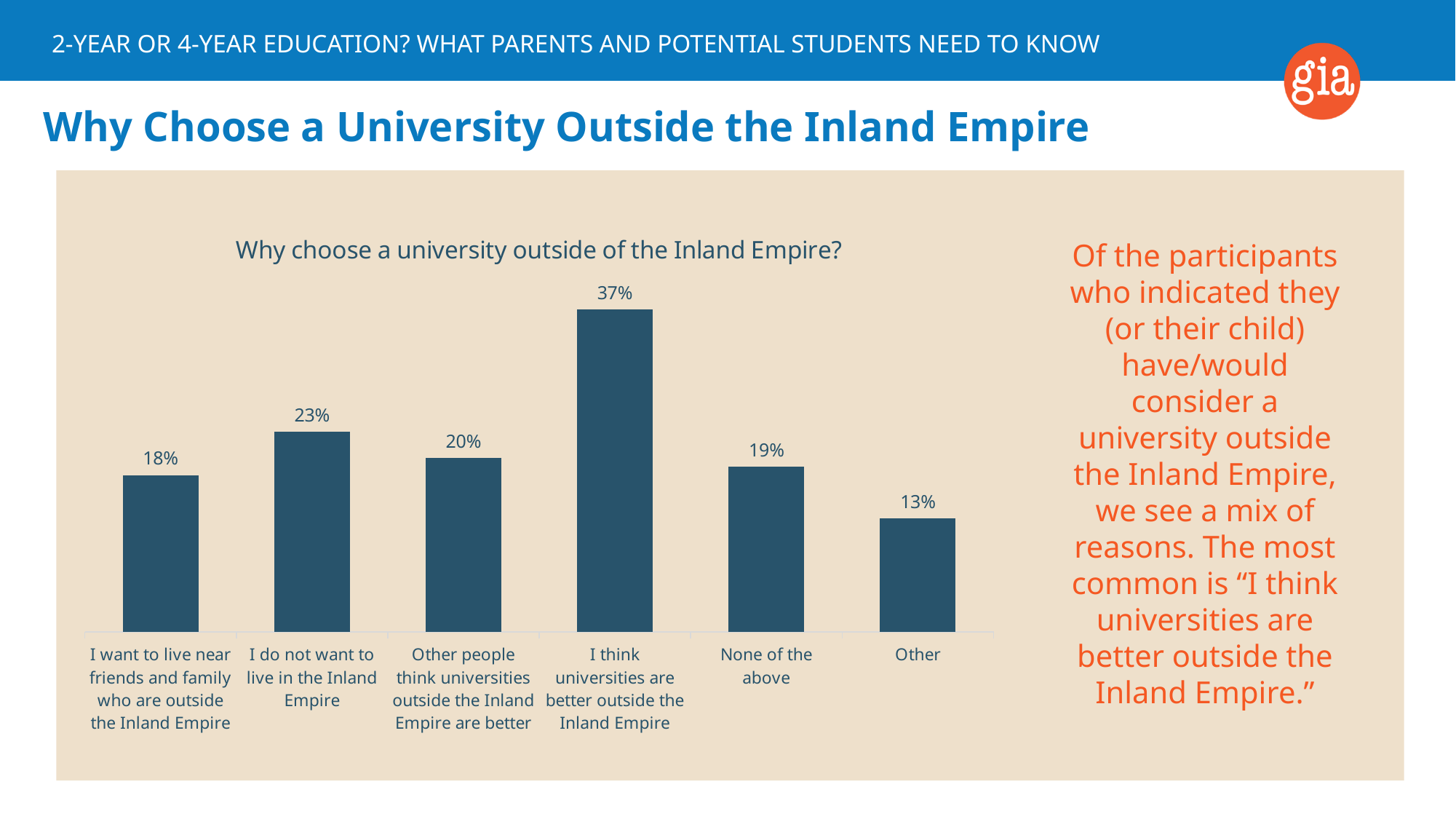
What is the difference between "I think universities are better outside the Inland Empire" and "I do not want to live in the Inland Empire"? 14% What is the difference between "Other people think universities outside the Inland Empire are better" and "Other"? 7% What type of chart is shown on the slide? Bar chart What percentage of respondents chose "I think universities are better outside the Inland Empire"? 37% Which reason has the highest percentage? I think universities are better outside the Inland Empire How many categories are shown in the chart? 6 What is the value for "I do not want to live in the Inland Empire"? 23% What is the value for the "Other" category? 13% What is the title of the chart? Why choose a university outside of the Inland Empire? Which category has the lowest percentage? Other Which is larger: "I want to live near friends and family who are outside the Inland Empire" or "I do not want to live in the Inland Empire"? I do not want to live in the Inland Empire What percentage is shown for "None of the above"? 19%